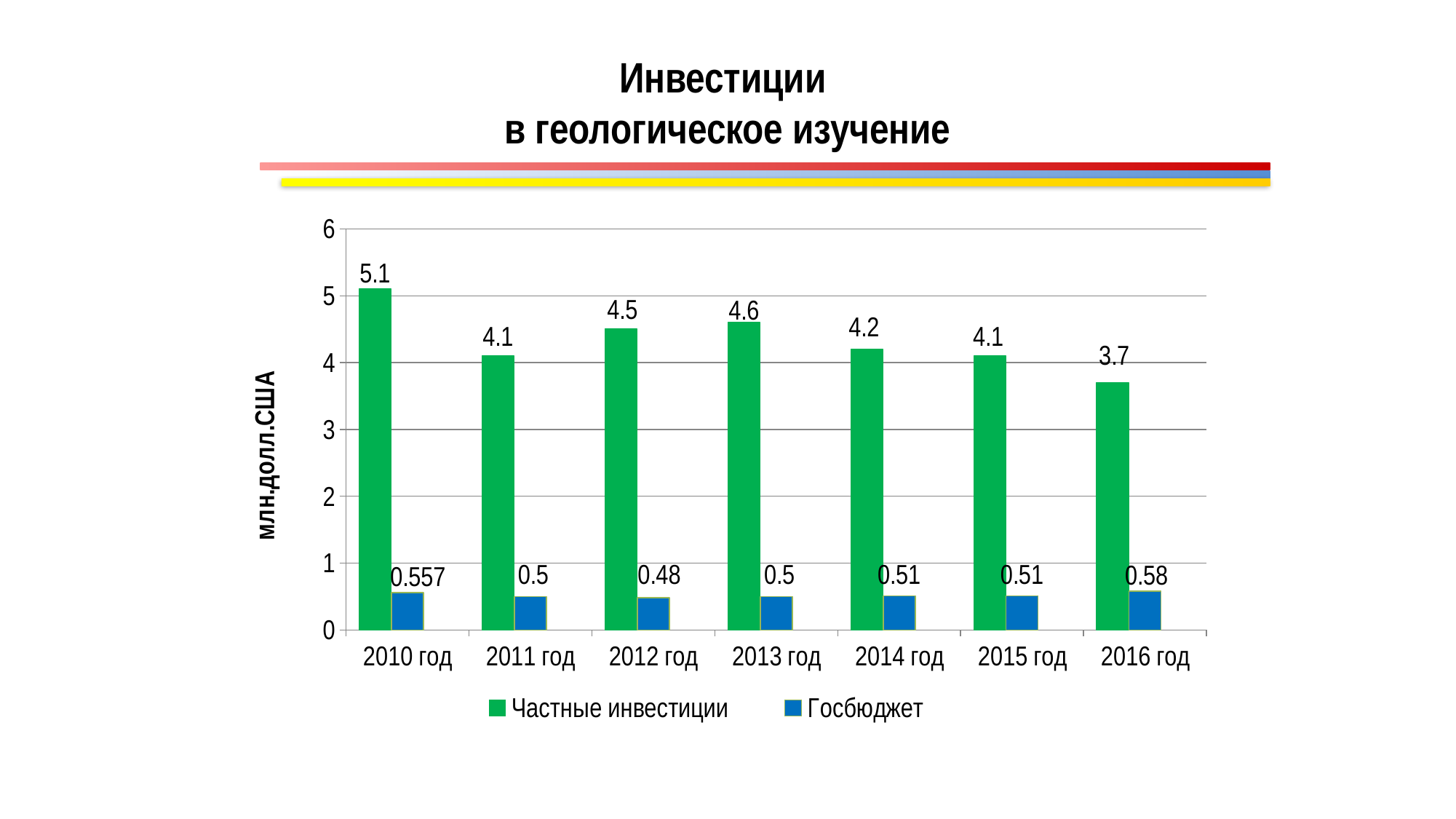
What is the value of Госбюджет for 2010 год? 0.557 Which year has the lowest value for Госбюджет? 2012 год Which year has the lowest value for Частные инвестиции? 2016 год How many years are shown on the x axis? 7 What is the label of the vertical axis? млн.долл.США Which is larger: Частные инвестиции in 2012 год or in 2013 год? 2013 год Which year has the highest value for Частные инвестиции? 2010 год What is the value of Частные инвестиции for 2010 год? 5.1 What is the difference between Частные инвестиции in 2010 год and 2016 год? 1.4 What kind of chart is shown on the slide? Bar chart What is the value of Госбюджет for 2012 год? 0.48 How many series does the legend list? 2